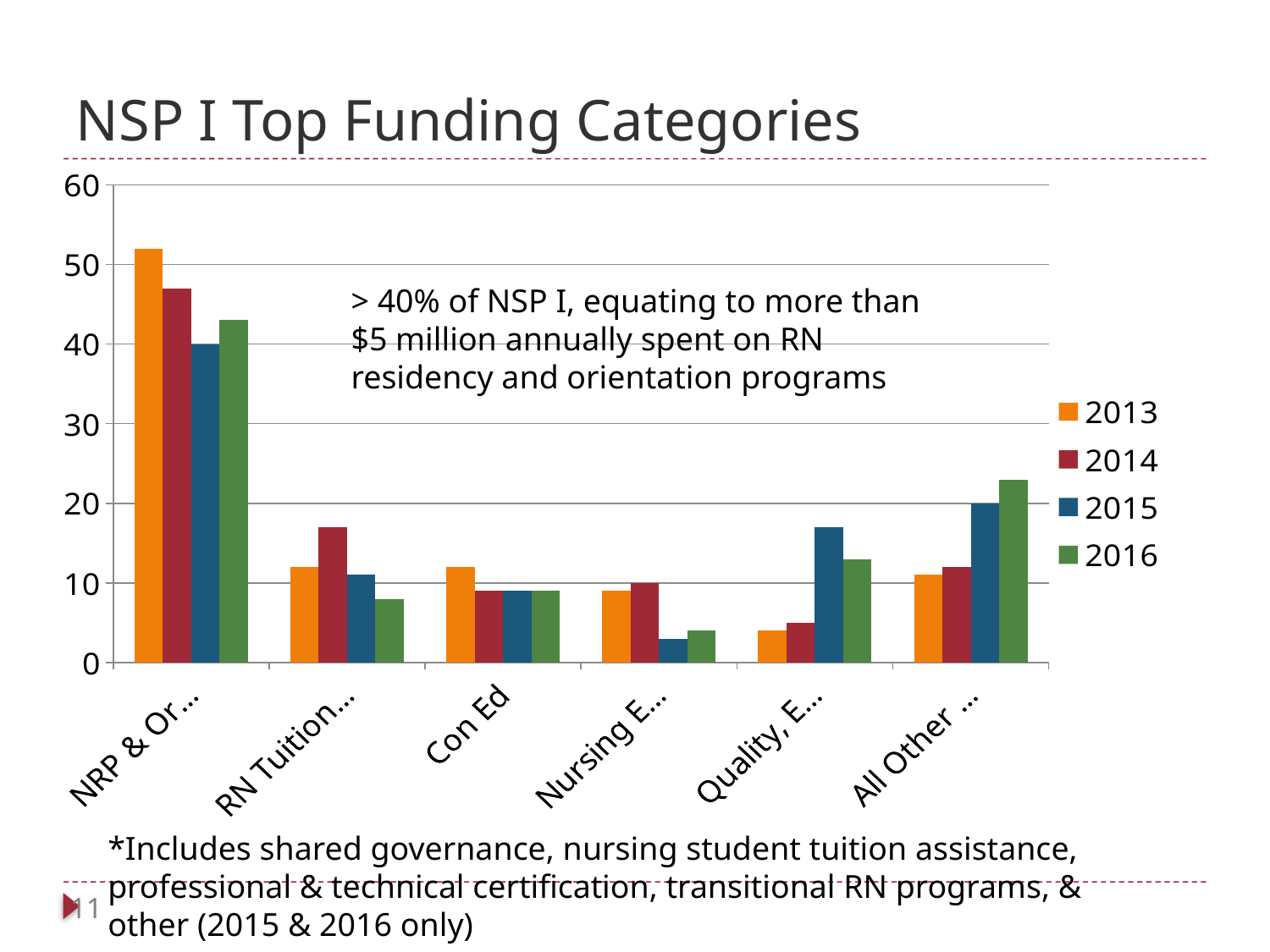
Which category has the tallest bar on the chart? NRP & Or... (the first category) How many categories are shown on the x axis? 6 What type of chart is shown on the slide? bar chart Which series has the highest value in the first category (NRP & Or...)? 2013 Which years are listed in the legend? 2013, 2014, 2015, 2016 Which series has the highest value in the Con Ed category? 2013 In the last category (All Other ...), do the values rise or fall from 2013 to 2016? rise Is the 2015 value for the Con Ed category greater or less than 10? less What is the title of the chart? NSP I Top Funding Categories In the Quality, E... category, which is larger, the 2015 value or the 2016 value? 2015 Is the 2013 value for the first category (NRP & Or...) greater or less than 50? greater How many series does the legend list? 4